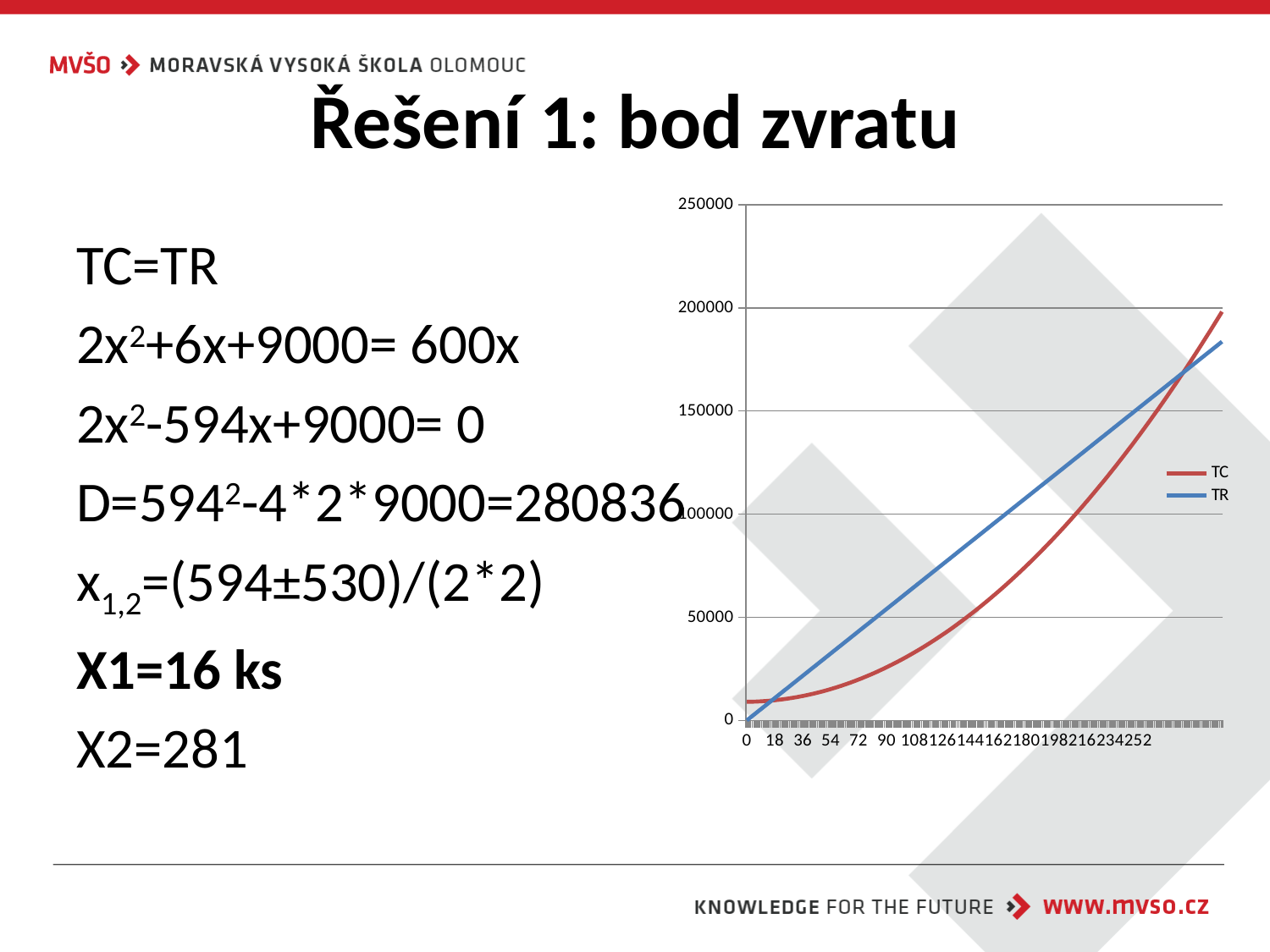
Is the value of TC at x = 126 greater or less than 50000? less What kind of chart is shown on the slide? line chart At x = 90, which series has the higher value, TC or TR? TR What colour is the TC line in the chart? red Is the value of TC at x = 234 greater or less than 100000? greater Does the TR line rise or fall as x increases along the x axis? rises How many series does the chart legend list? 2 What is the highest value shown on the chart's y axis? 250000 Is the value of TR at x = 126 greater or less than 50000? greater At x = 0, which series has the higher value, TC or TR? TC Does the TC line rise or fall as x increases along the x axis? rises What are the two series named in the chart legend? TC and TR